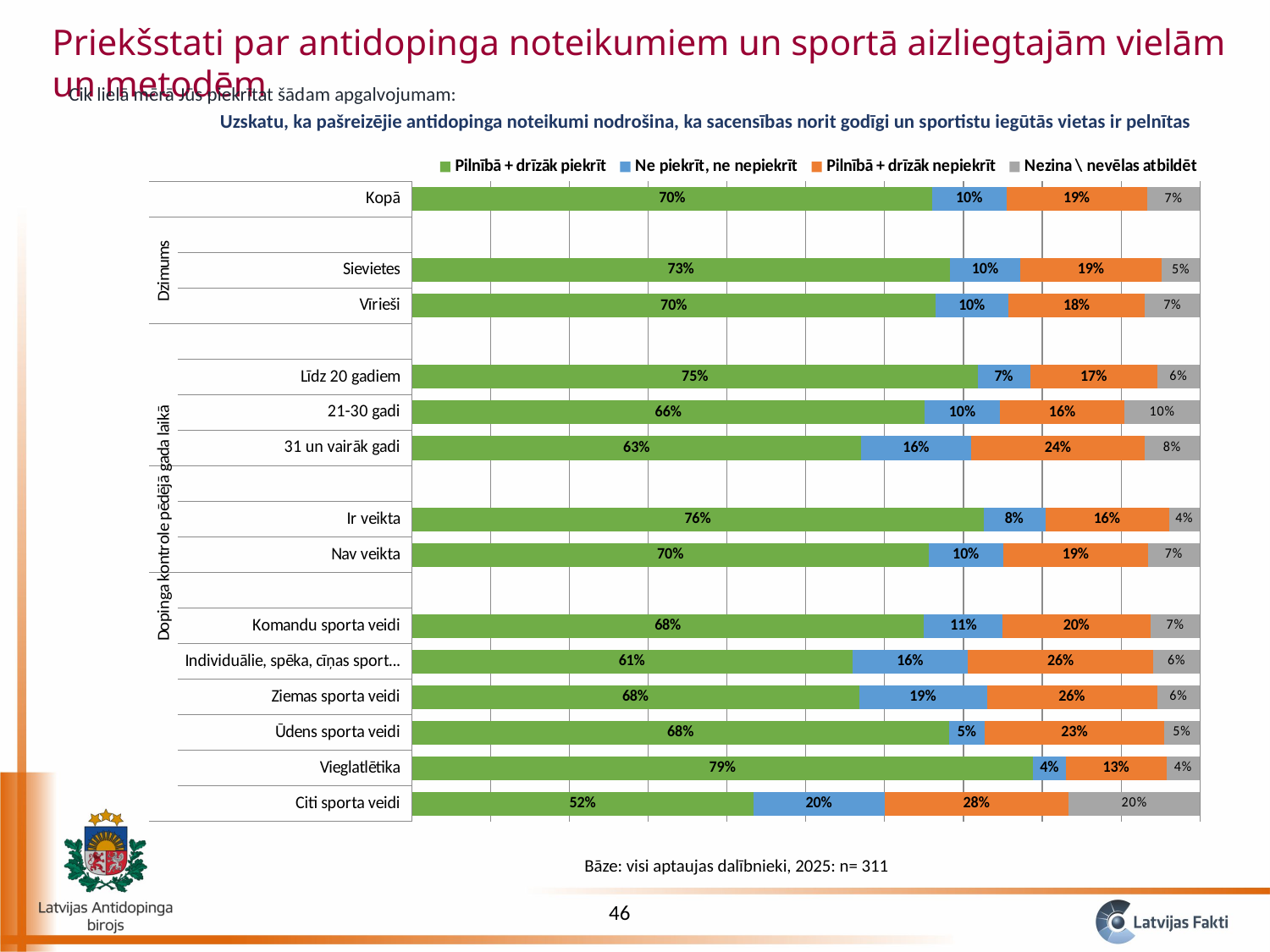
Which is larger: the "Pilnībā + drīzāk nepiekrīt" value for Ir veikta or for Nav veikta? Nav veikta What is the value of "Nezina \ nevēlas atbildēt" for 21-30 gadi? 10% How many categories are plotted in the chart? 14 Which category has the lowest value for "Pilnībā + drīzāk piekrīt"? Citi sporta veidi What is the value of "Pilnībā + drīzāk nepiekrīt" for 31 un vairāk gadi? 24% What is the difference between the "Pilnībā + drīzāk piekrīt" values for Sievietes and Vīrieši? 3 percentage points Which category has the highest value for "Pilnībā + drīzāk piekrīt"? Vieglatlētika What kind of chart is shown on the slide? Stacked bar chart How many series does the legend list? 4 What is the value of "Pilnībā + drīzāk piekrīt" for Kopā? 70% What is the value of "Ne piekrīt, ne nepiekrīt" for Citi sporta veidi? 20% Which series is shown in green in the legend? Pilnībā + drīzāk piekrīt